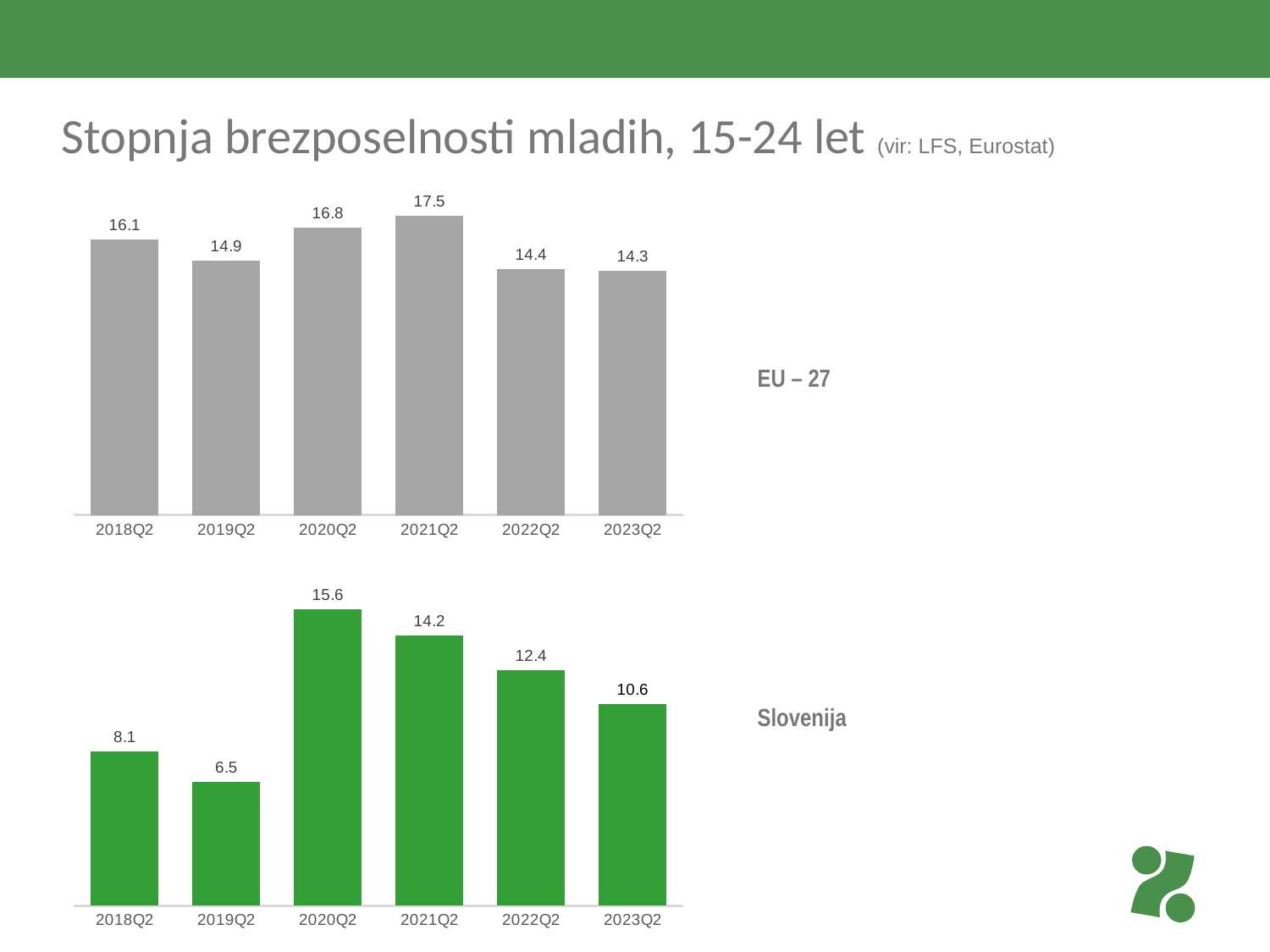
In the Slovenija chart (bottom), which is larger, the value for 2021Q2 or 2022Q2? 2021Q2 In the Slovenija chart (bottom), which quarter has the lowest value? 2019Q2 In the Slovenija chart (bottom), what is the value for 2019Q2? 6.5 In the EU – 27 chart (top), which quarter has the lowest value? 2023Q2 In the EU – 27 chart (top), what is the difference between the 2021Q2 and 2023Q2 values? 3.2 What kind of chart is the Slovenija chart (bottom)? Bar chart In the Slovenija chart (bottom), which quarter has the highest value? 2020Q2 In the Slovenija chart (bottom), what is the difference between the 2020Q2 and 2018Q2 values? 7.5 What colour are the bars in the EU – 27 chart (top)? Grey In the Slovenija chart (bottom), do the values rise or fall from 2020Q2 to 2023Q2? Fall How many quarters are shown in the EU – 27 chart (top)? 6 In the EU – 27 chart (top), what is the value for 2021Q2? 17.5